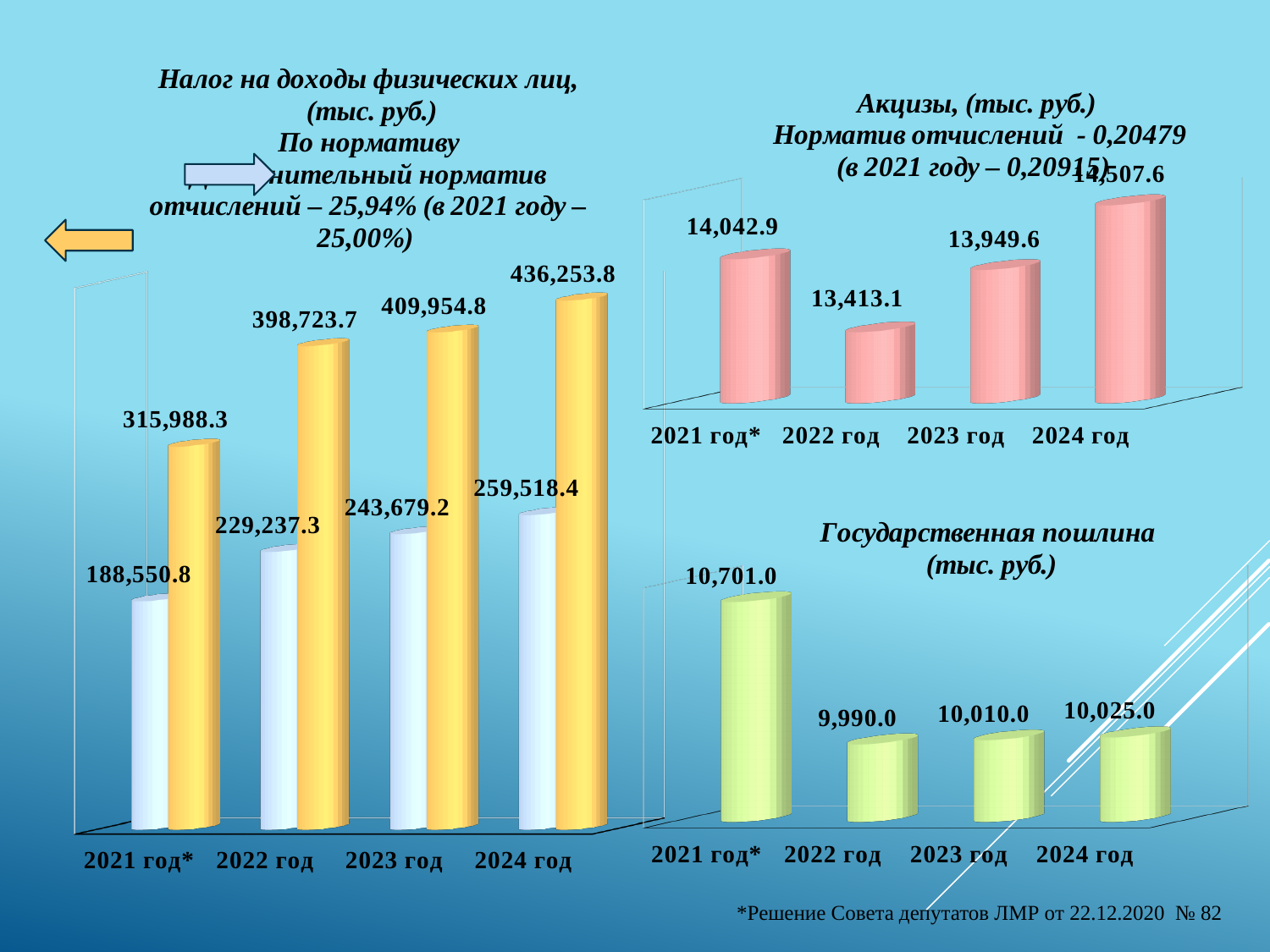
In the 'Налог на доходы физических лиц' chart, what is the value of the yellow bar for 2024 год? 436,253.8 In the 'Налог на доходы физических лиц' chart, do the yellow bar values rise or fall from 2021 год* to 2024 год? rise In the 'Государственная пошлина (тыс. руб.)' chart, what is the difference between the values for 2024 год and 2023 год? 15.0 In the 'Налог на доходы физических лиц' chart, what is the difference between the yellow and light blue bars for 2022 год? 169,486.4 In the 'Государственная пошлина (тыс. руб.)' chart, what is the value for 2021 год*? 10,701.0 In the 'Акцизы, (тыс. руб.)' chart, which year has the highest value? 2024 год In the 'Акцизы, (тыс. руб.)' chart, which year has the lowest value? 2022 год In the 'Налог на доходы физических лиц' chart, what is the value of the light blue bar for 2021 год*? 188,550.8 In the 'Государственная пошлина (тыс. руб.)' chart, which year has the lowest value? 2022 год What kind of chart is the 'Государственная пошлина (тыс. руб.)' chart? bar chart In the 'Акцизы, (тыс. руб.)' chart, what is the value for 2022 год? 13,413.1 How many years are shown on the x axis of the 'Акцизы, (тыс. руб.)' chart? 4